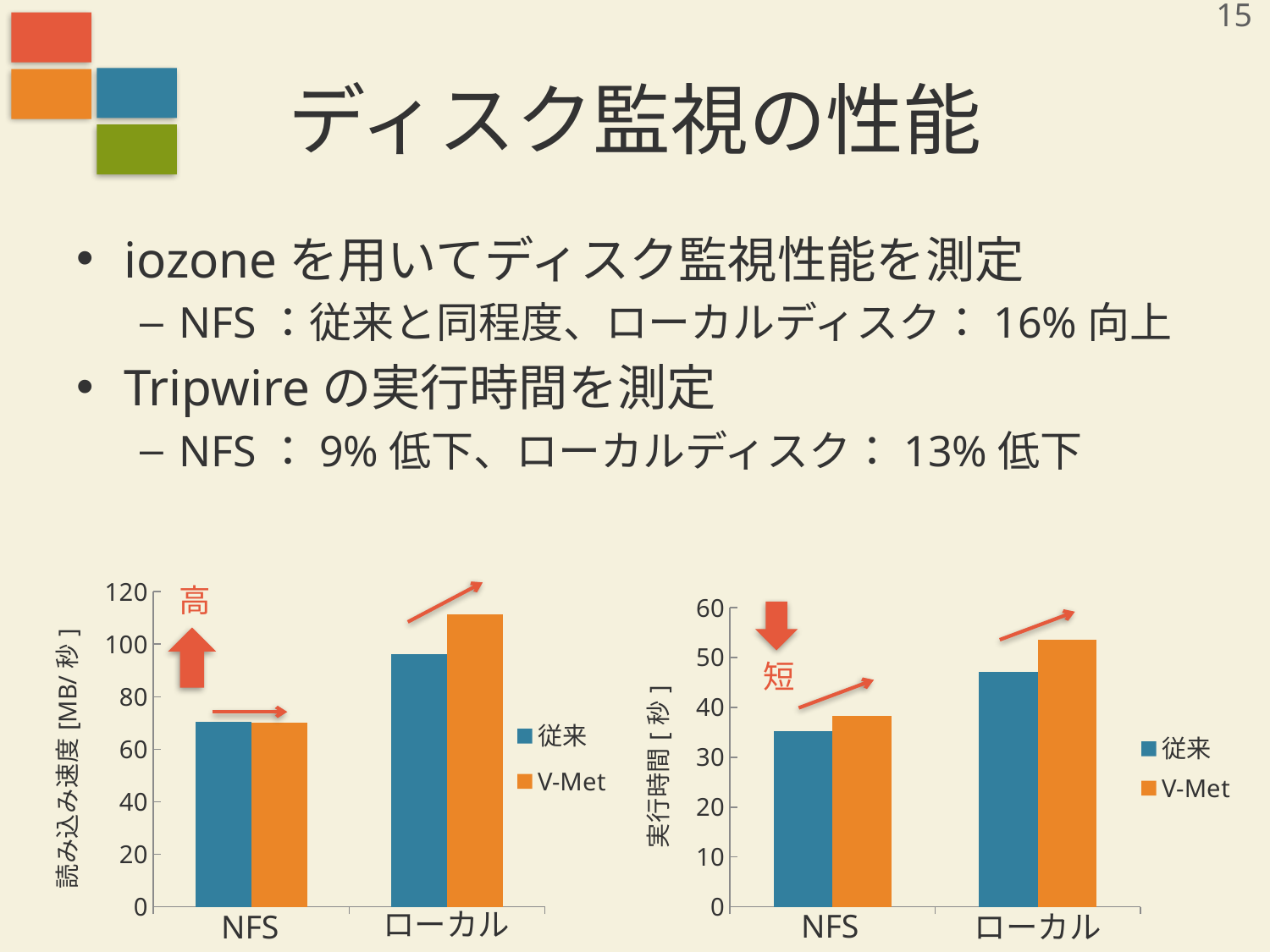
What is the y-axis title of the right chart? 実行時間 [秒] In the left chart (読み込み速度), is the V-Met value for ローカル greater or less than 100? greater In the right chart (実行時間), is the V-Met value for ローカル greater or less than 50? greater In the left chart (読み込み速度), for ローカル, which series has the larger value, 従来 or V-Met? V-Met In the left chart (読み込み速度), which category has the highest V-Met bar? ローカル How many categories are shown on the x axis of the left chart (読み込み速度)? 2 In the left chart (読み込み速度), is the 従来 value for NFS greater or less than 80? less What kind of chart is the left chart (読み込み速度)? bar chart In the right chart (実行時間), which category has the lowest 従来 bar? NFS How many series does the legend of the right chart (実行時間) list? 2 In the right chart (実行時間), for ローカル, which series has the larger value, 従来 or V-Met? V-Met